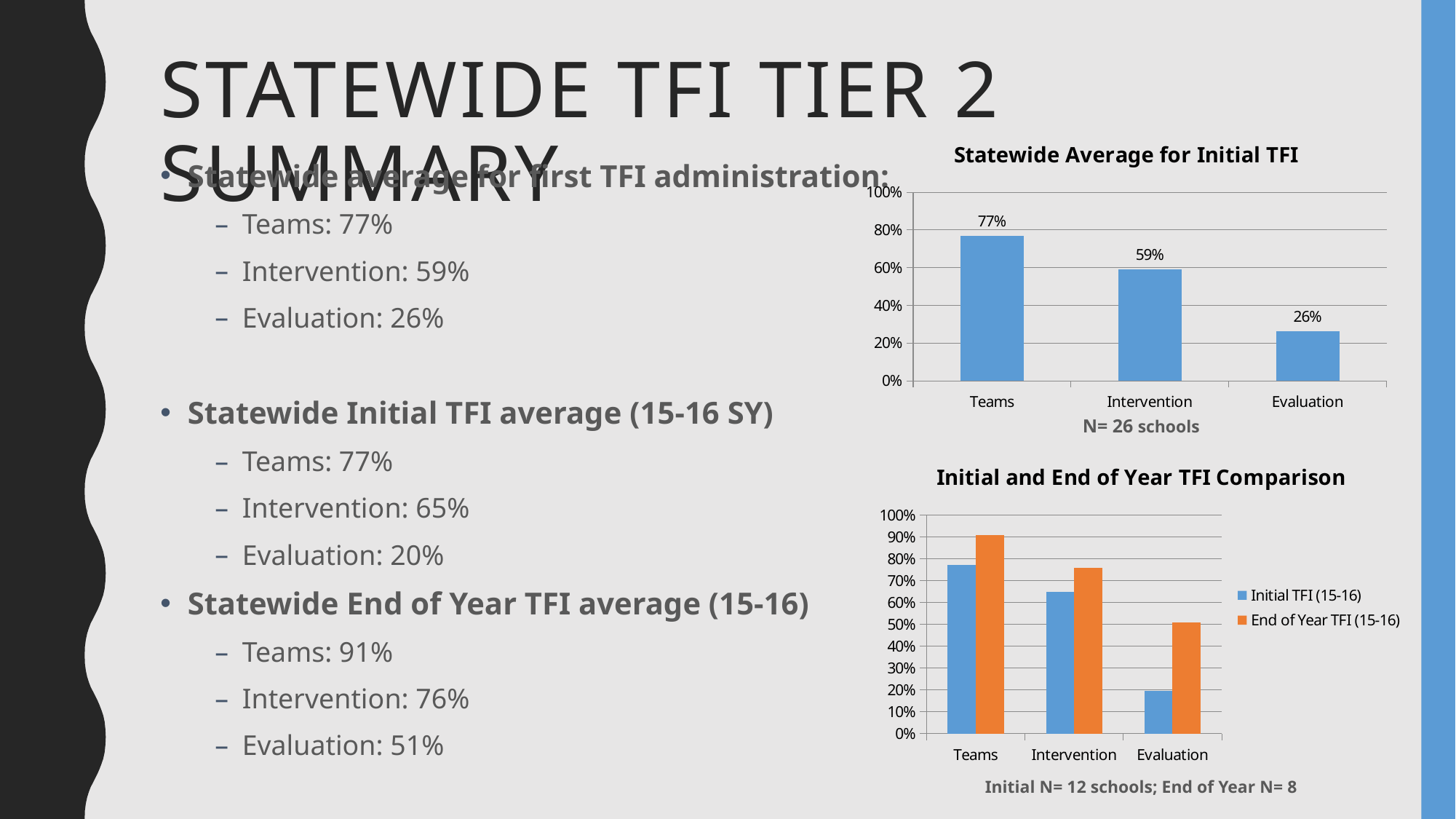
What kind of chart is the 'Initial and End of Year TFI Comparison' chart? bar chart In the 'Initial and End of Year TFI Comparison' chart, is the End of Year TFI (15-16) value for Teams greater or less than 80%? greater In the 'Initial and End of Year TFI Comparison' chart, which is larger for Intervention: Initial TFI (15-16) or End of Year TFI (15-16)? End of Year TFI (15-16) In the 'Statewide Average for Initial TFI' chart, what is the value for Evaluation? 26% In the 'Statewide Average for Initial TFI' chart, which category has the lowest value? Evaluation In the 'Statewide Average for Initial TFI' chart, how many categories are shown on the x axis? 3 In the 'Statewide Average for Initial TFI' chart, what is the difference between the Teams and Evaluation values? 51% In the 'Initial and End of Year TFI Comparison' chart, is the Initial TFI (15-16) value for Evaluation greater or less than 30%? less In the 'Statewide Average for Initial TFI' chart, what is the value for Teams? 77% In the 'Statewide Average for Initial TFI' chart, do the values rise or fall from Teams to Evaluation? fall In the 'Statewide Average for Initial TFI' chart, what is the value for Intervention? 59% In the 'Initial and End of Year TFI Comparison' chart, how many series does the legend list? 2